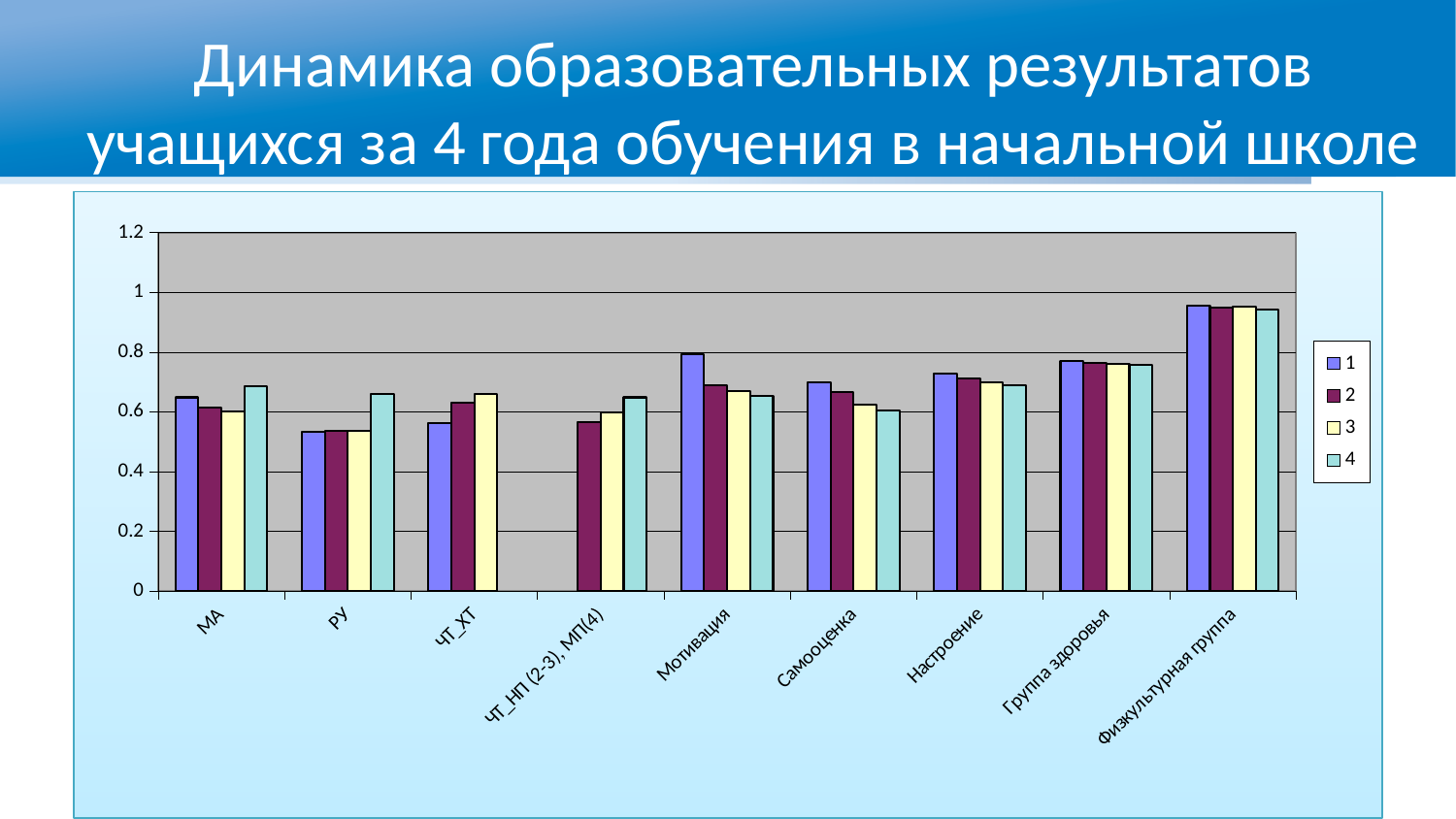
Is the value for series 4 in Самооценка greater or less than 0.8? less Which category has the lowest value for series 1? РУ What kind of chart is shown on the slide? bar chart Is the value for series 1 in РУ greater or less than 0.6? less For Мотивация, do the values rise or fall from series 1 to series 4? fall Is the value for series 1 in Физкультурная группа greater or less than 0.8? greater Which category has the highest value for series 1? Физкультурная группа For РУ, which is larger: the value for series 4 or the value for series 1? series 4 How many series does the legend list? 4 What is the title of the slide? Динамика образовательных результатов учащихся за 4 года обучения в начальной школе How many categories are shown on the x axis? 9 What are the entries listed in the legend? 1, 2, 3, 4